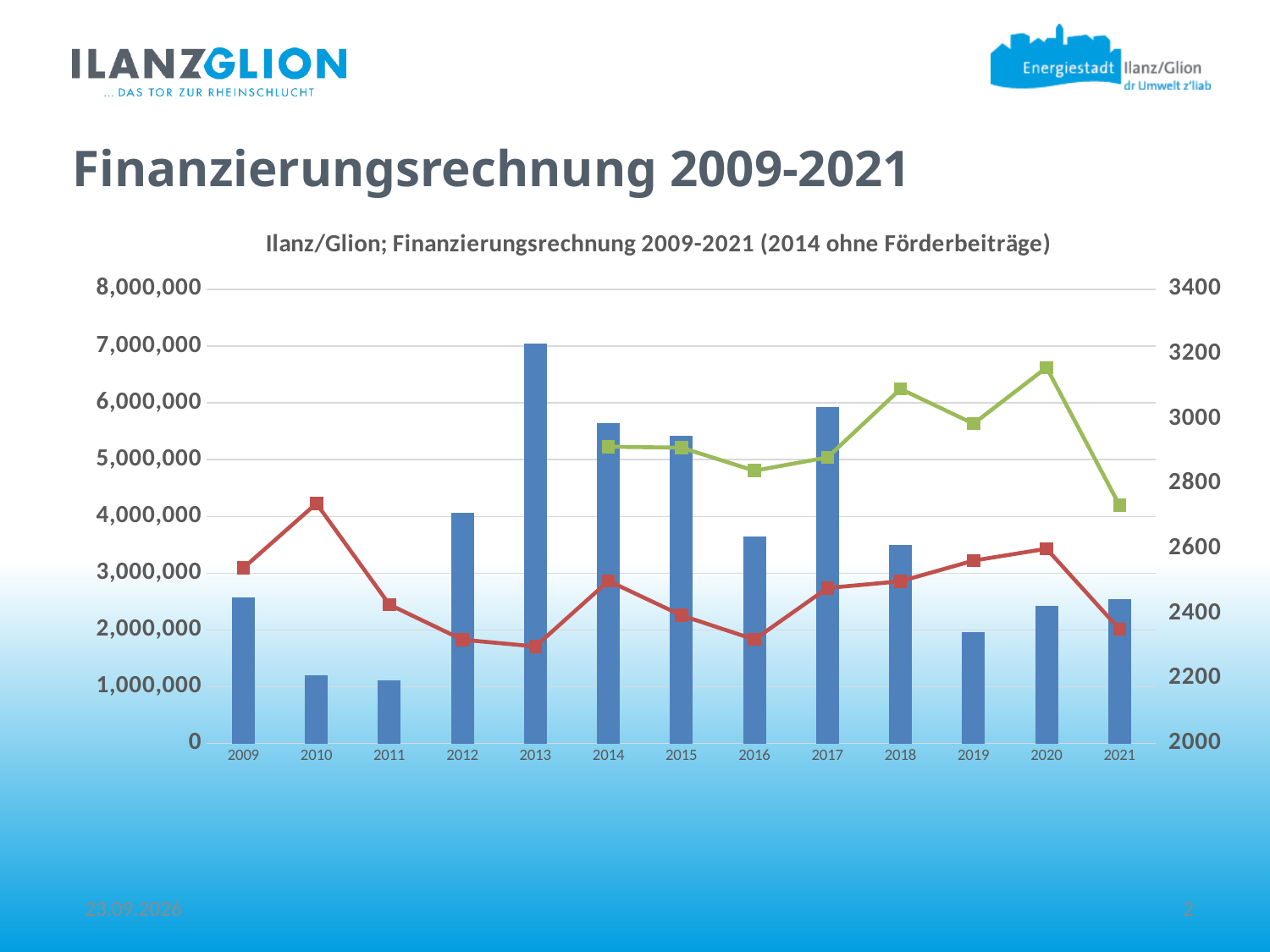
In which year does the red line reach its highest point? 2010 What kind of chart is shown on the slide? A bar chart combined with line series Does the green line rise or fall from 2020 to 2021? fall In which year does the green line reach its highest point? 2020 Is the blue bar for 2013 greater or less than 6,000,000? greater Is the blue bar for 2009 greater or less than 3,000,000? less How many years are shown on the x axis of the chart? 13 In which year is the blue bar the highest? 2013 What is the title of the chart? Ilanz/Glion; Finanzierungsrechnung 2009-2021 (2014 ohne Förderbeiträge) Is the blue bar for 2016 greater or less than 3,000,000? greater Which blue bar is taller, 2014 or 2015? 2014